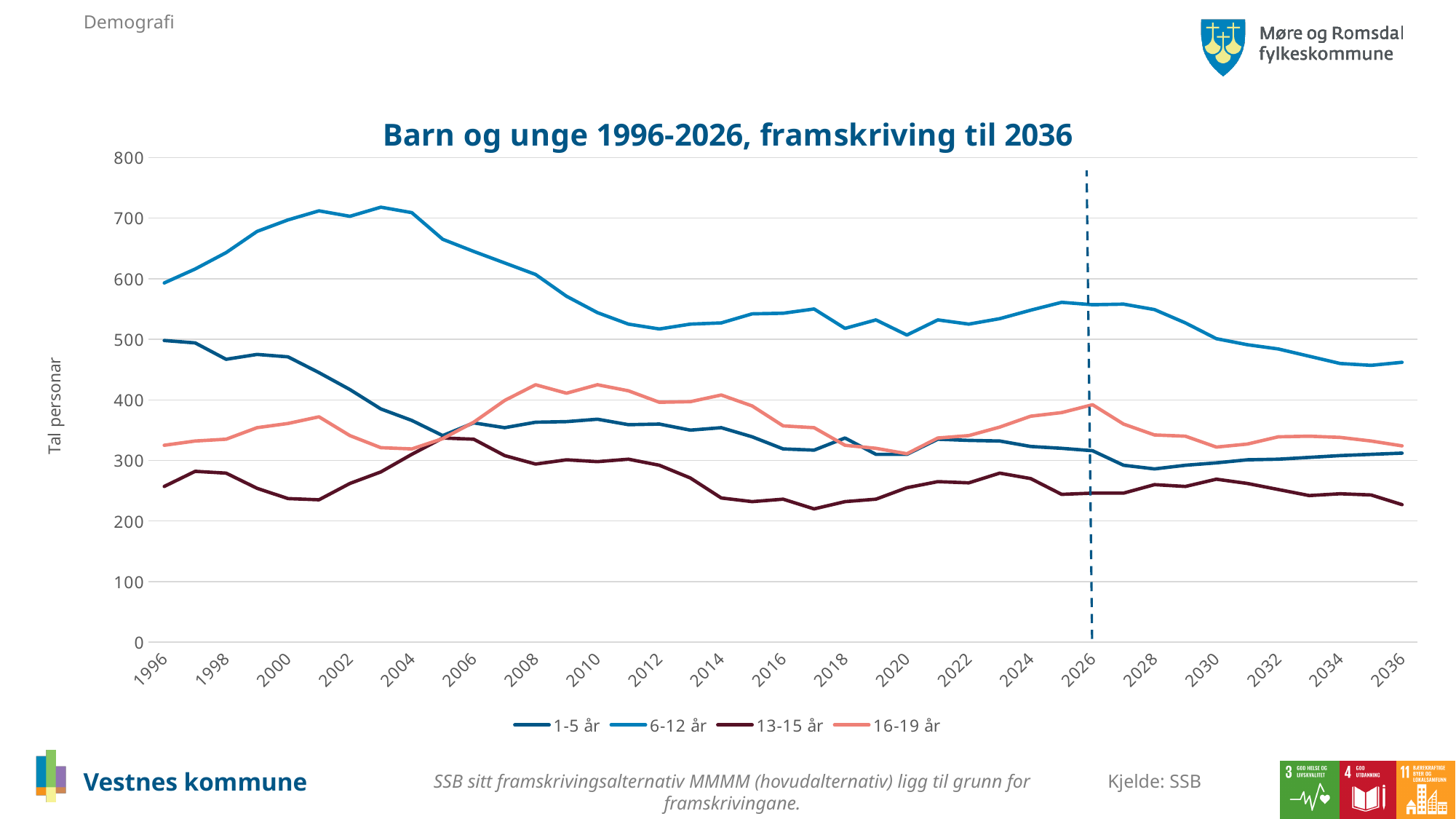
Is the value for 6-12 år in 2003 greater or less than 700? greater At which year is the dashed vertical line drawn on the chart? 2026 Is the value for 13-15 år in 2017 greater or less than 250? less In 1996, which is larger: the value for 6-12 år or the value for 1-5 år? 6-12 år Does the 1-5 år series rise or fall from 1996 to 2004? fall How many series does the legend list? 4 Which series has the lowest value in 2036? 13-15 år Does the 6-12 år series rise or fall from 2026 to 2036? fall Is the value for 16-19 år in 2008 greater or less than 400? greater Which series has the highest value in 2010? 6-12 år What kind of chart is shown on the slide? line chart What is the title of the chart? Barn og unge 1996-2026, framskriving til 2036